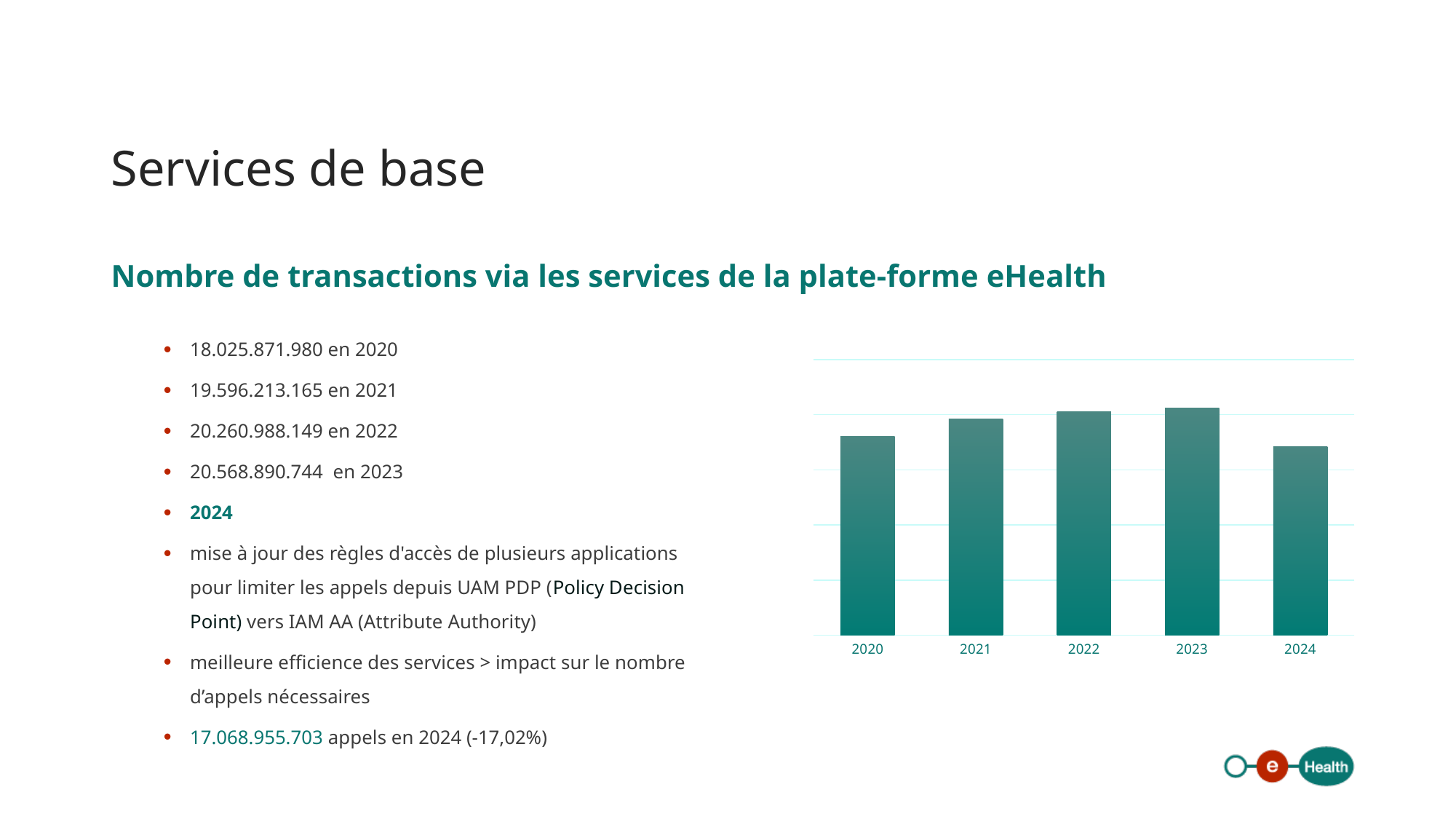
Is the bar for 2020 taller or shorter than the bar for 2024? taller What kind of chart is shown on the slide? bar chart According to the slide, what is the number of transactions in 2024? 17.068.955.703 Which year has the lowest bar in the chart? 2024 Which year has the highest bar in the chart? 2023 According to the slide, what is the number of transactions in 2023? 20.568.890.744 Does the value rise or fall from 2023 to 2024? fall How many years are plotted in the chart? 5 What percentage change for 2024 is stated on the slide? -17,02% Which bar is taller, 2021 or 2022? 2022 How do the values change from 2020 to 2023? they rise each year What is the difference between the 2023 and 2024 values given on the slide? 3.499.935.041